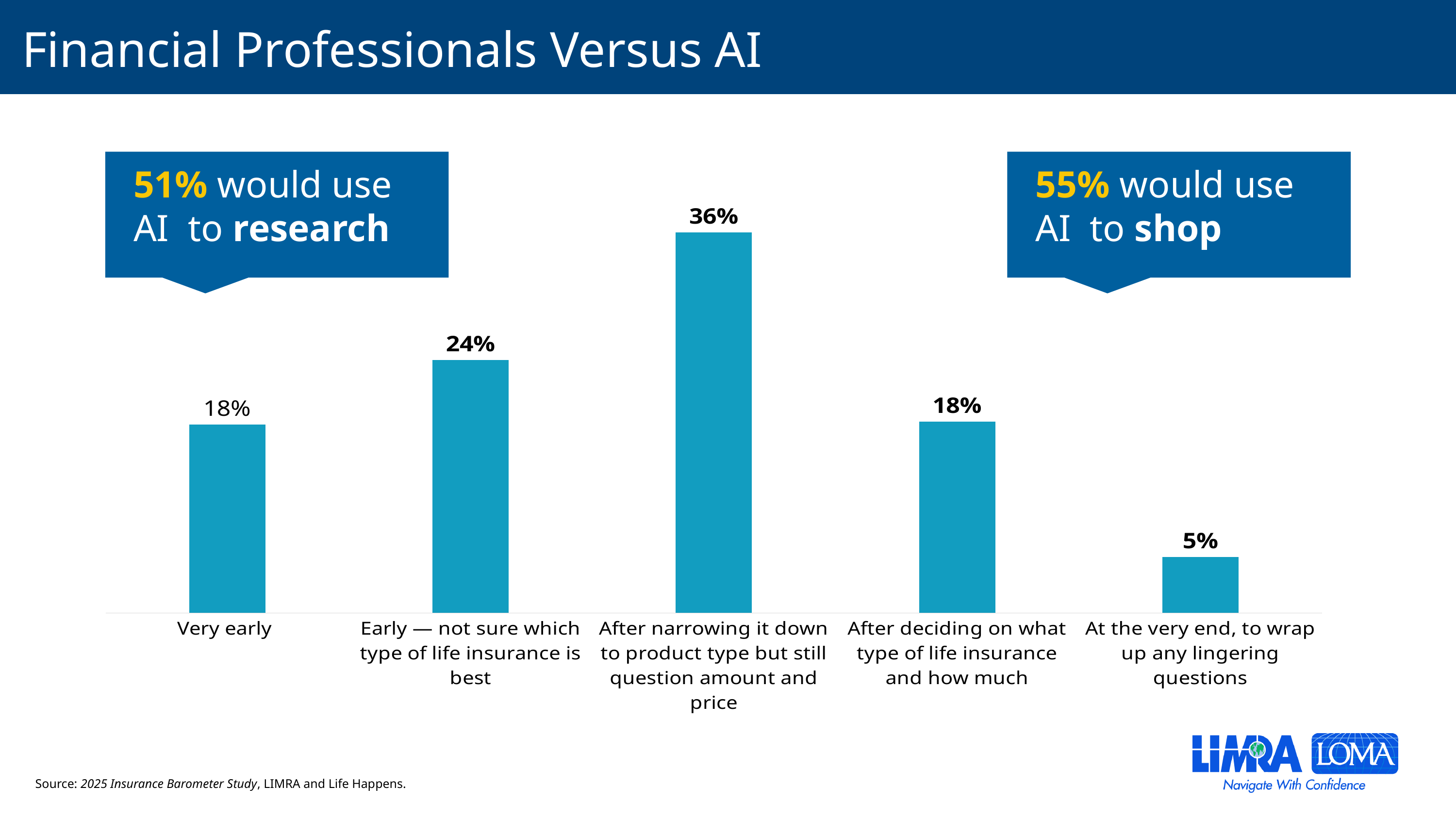
What is the value for "At the very end, to wrap up any lingering questions"? 5% Which category has the lowest value? At the very end, to wrap up any lingering questions What is the value for "Early — not sure which type of life insurance is best"? 24% What is the difference between the values for "After narrowing it down to product type but still question amount and price" and "Early — not sure which type of life insurance is best"? 12% What kind of chart is shown on the slide? Bar chart Which category has the highest value? After narrowing it down to product type but still question amount and price What is the value for "After narrowing it down to product type but still question amount and price"? 36% According to the callout on the right, what percentage would use AI to shop? 55% What is the value for "Very early"? 18% How many categories are shown in the chart? 5 According to the callout on the left, what percentage would use AI to research? 51% Which is larger, the value for "Early — not sure which type of life insurance is best" or the value for "After deciding on what type of life insurance and how much"? Early — not sure which type of life insurance is best